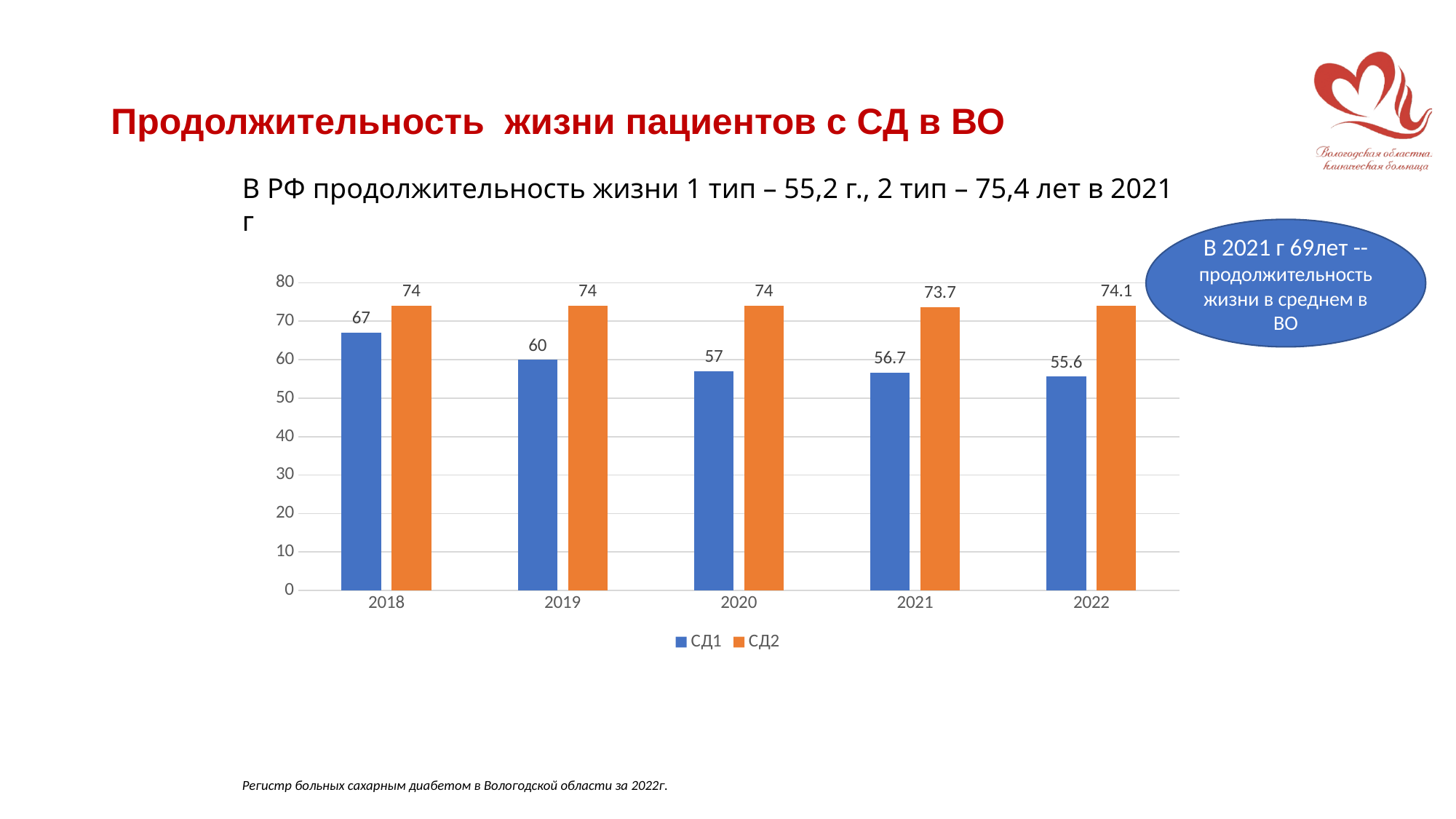
What is the value for СД1 in 2018? 67 What is the value for СД2 in 2021? 73.7 In which year is the СД1 value lowest? 2022 What is the difference between the СД1 values in 2018 and 2019? 7 What kind of chart is shown on the slide? Bar chart What is the difference between the СД2 and СД1 values in 2020? 17 What is the value for СД1 in 2022? 55.6 In which year is the СД1 value highest? 2018 Which is larger in 2022, the СД1 value or the СД2 value? СД2 How many series does the legend list? 2 How many years are shown on the x axis? 5 Do the СД1 values rise or fall from 2018 to 2022? Fall